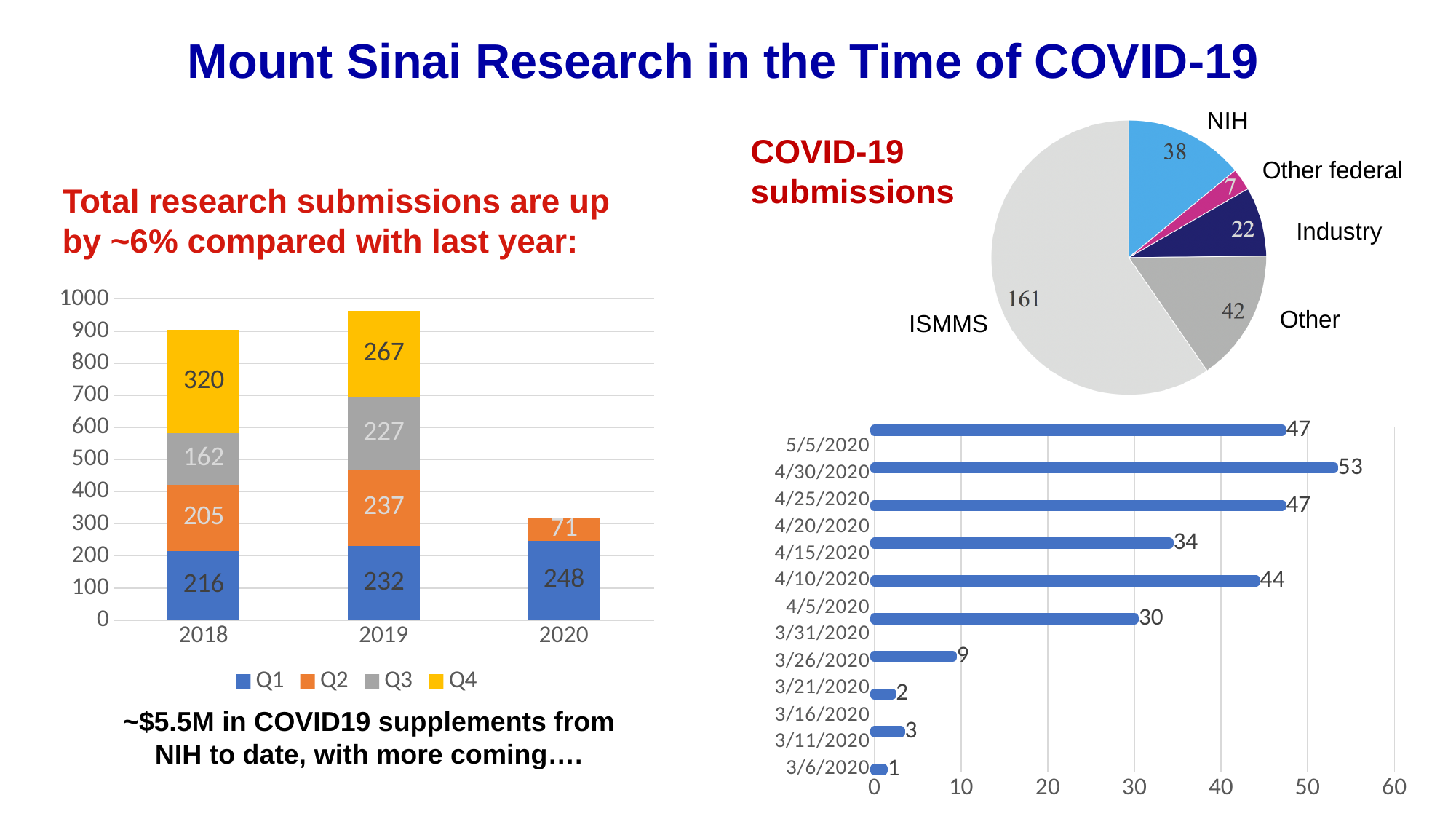
In the COVID-19 submissions pie chart, which is larger, NIH or Other? Other In the stacked bar chart on the left, which year has the lowest total bar? 2020 In the stacked bar chart on the left, what is the Q4 value for 2018? 320 In the stacked bar chart on the left, what is the Q1 value for 2020? 248 In the COVID-19 submissions pie chart, what is the value for Industry? 22 In the stacked bar chart on the left, what is the difference between the Q2 values for 2019 and 2018? 32 What kind of chart is the one at the bottom right of the slide? Bar chart In the COVID-19 submissions pie chart, which category has the largest slice? ISMMS In the stacked bar chart on the left, how many series does the legend list? 4 In the stacked bar chart on the left, which colour represents Q3? Grey In the stacked bar chart on the left, what is the total of the 2019 bar? 963 In the horizontal bar chart at the bottom right, what is the highest value shown? 53